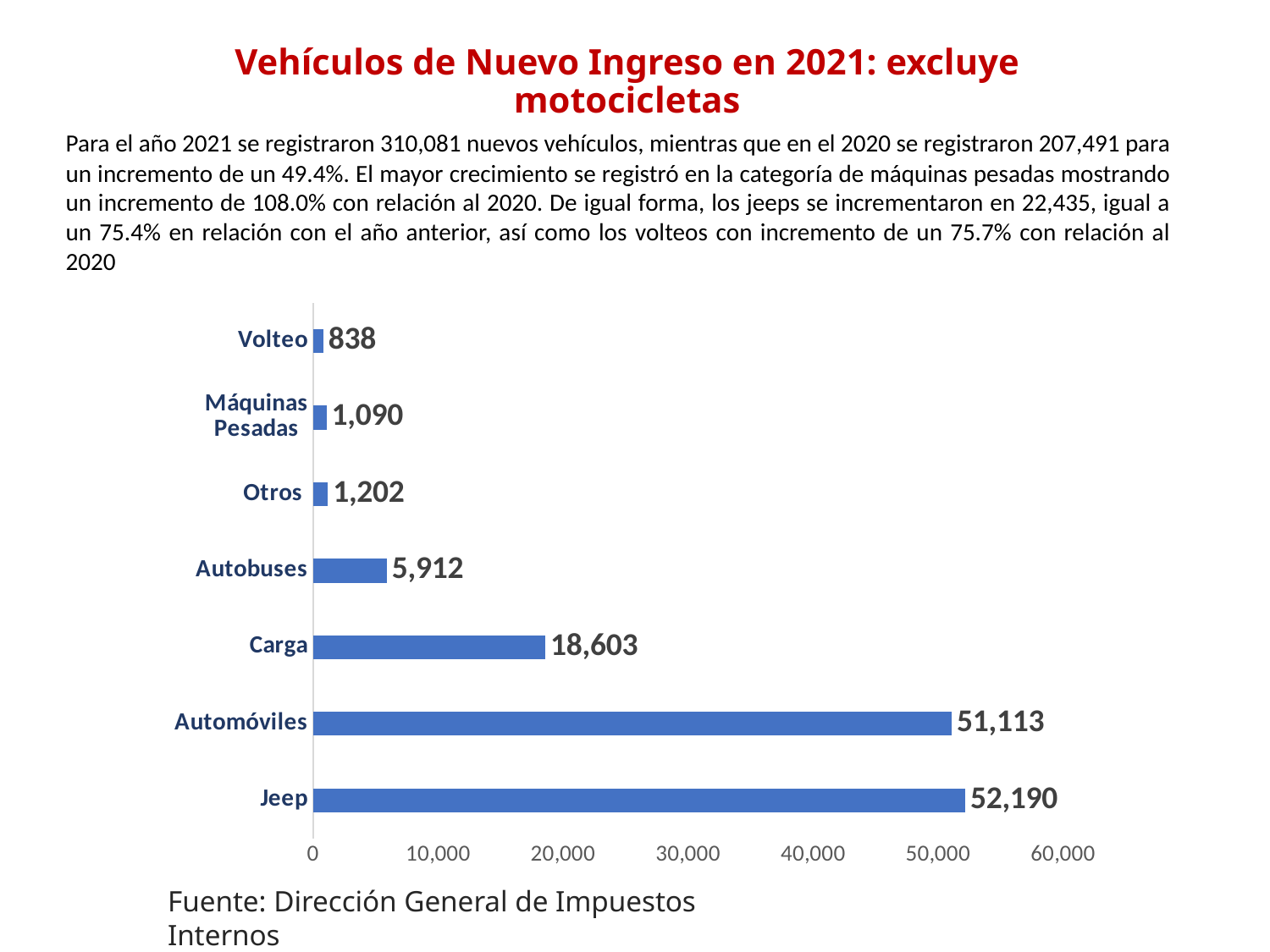
What is the difference between the values for Jeep and Automóviles? 1,077 Which is larger, the value for Otros or the value for Máquinas Pesadas? Otros What is the source cited below the chart? Dirección General de Impuestos Internos Which category has the lowest value? Volteo Is the value for Automóviles greater or less than 50,000? greater What is the difference between the values for Carga and Autobuses? 12,691 What kind of chart is shown on the slide? bar chart Which category has the highest value? Jeep What is the value for Jeep? 52,190 What is the value for Máquinas Pesadas? 1,090 What is the value for Carga? 18,603 How many categories are shown in the chart? 7